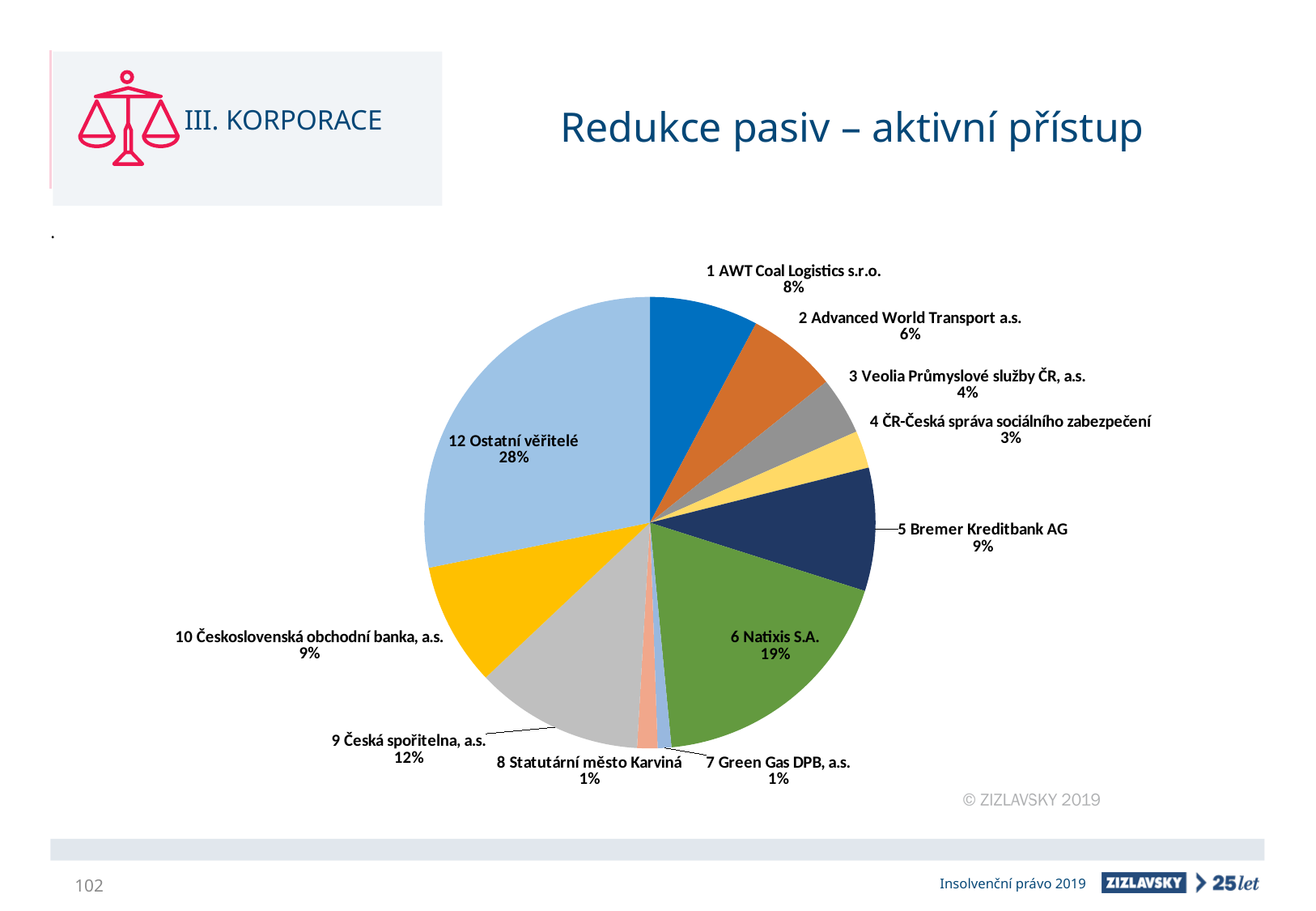
What is the title of the slide containing the pie chart? Redukce pasiv – aktivní přístup Which category has the largest slice of the pie? 12 Ostatní věřitelé What percentage is shown for 7 Green Gas DPB, a.s.? 1% What percentage is shown for 12 Ostatní věřitelé? 28% What percentage is shown for 4 ČR-Česká správa sociálního zabezpečení? 3% What is the difference in percentage points between 12 Ostatní věřitelé and 10 Československá obchodní banka, a.s.? 19 percentage points What share of the pie does 6 Natixis S.A. hold? 19% What percentage is shown for 9 Česká spořitelna, a.s.? 12% What kind of chart is shown on the slide? pie chart Which has the larger share: 1 AWT Coal Logistics s.r.o. or 2 Advanced World Transport a.s.? 1 AWT Coal Logistics s.r.o. What is the difference in percentage points between 6 Natixis S.A. and 9 Česká spořitelna, a.s.? 7 percentage points What percentage is shown for 5 Bremer Kreditbank AG? 9%